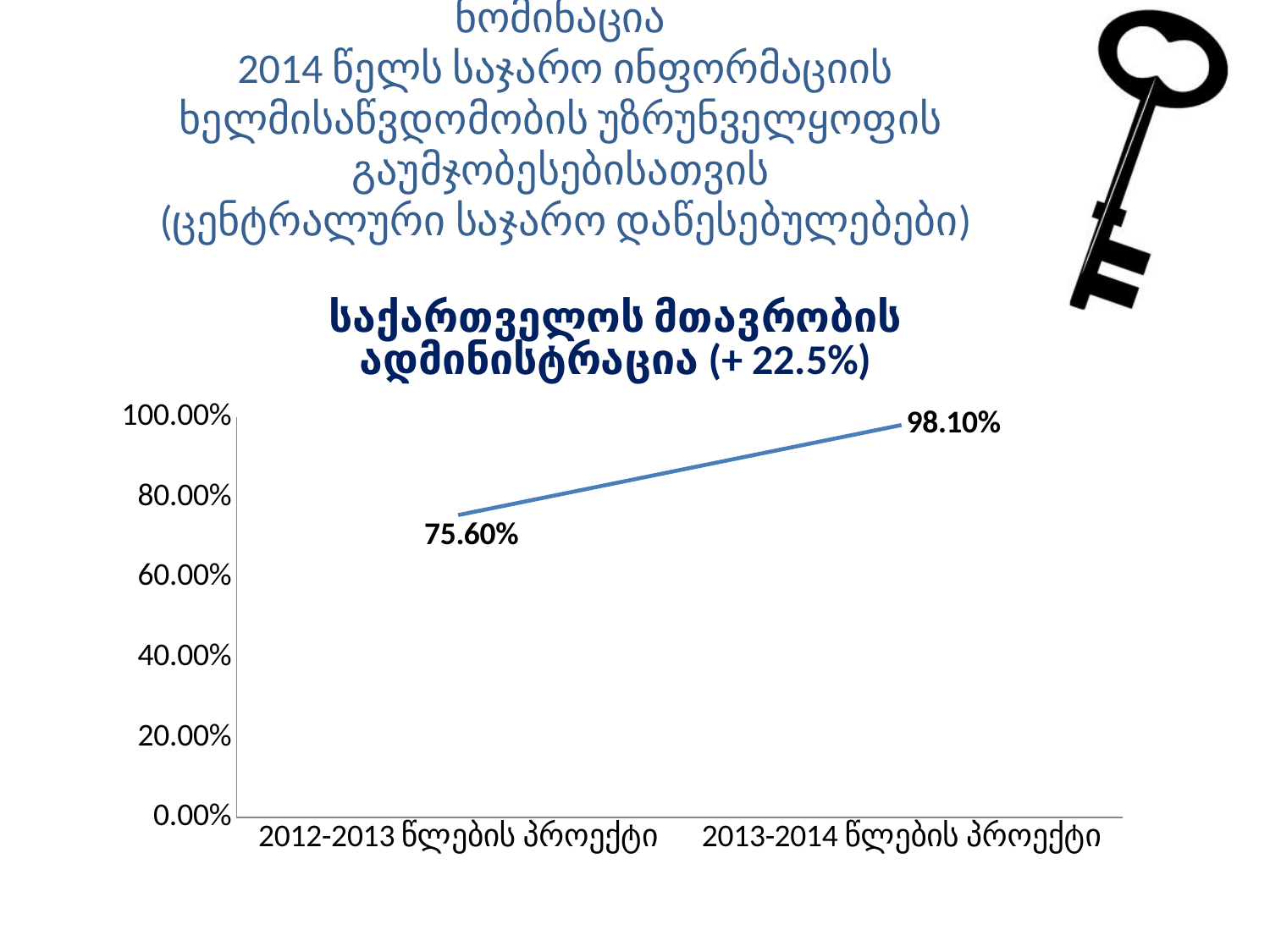
How many data points are plotted on the chart? 2 What kind of chart is shown on the slide? line chart Is the value for 2013-2014 წლების პროექტი greater or less than 80.00%? greater Which is larger, the value for 2012-2013 წლების პროექტი or 2013-2014 წლების პროექტი? 2013-2014 წლების პროექტი Which category has the highest value? 2013-2014 წლების პროექტი Do the values rise or fall from 2012-2013 წლების პროექტი to 2013-2014 წლების პროექტი? rise Is the value for 2012-2013 წლების პროექტი greater or less than 80.00%? less What is the title of the chart? საქართველოს მთავრობის ადმინისტრაცია (+ 22.5%) What is the value for 2013-2014 წლების პროექტი? 98.10% Which category has the lowest value? 2012-2013 წლების პროექტი What is the difference between the values for 2013-2014 წლების პროექტი and 2012-2013 წლების პროექტი? 22.50% What is the value for 2012-2013 წლების პროექტი? 75.60%